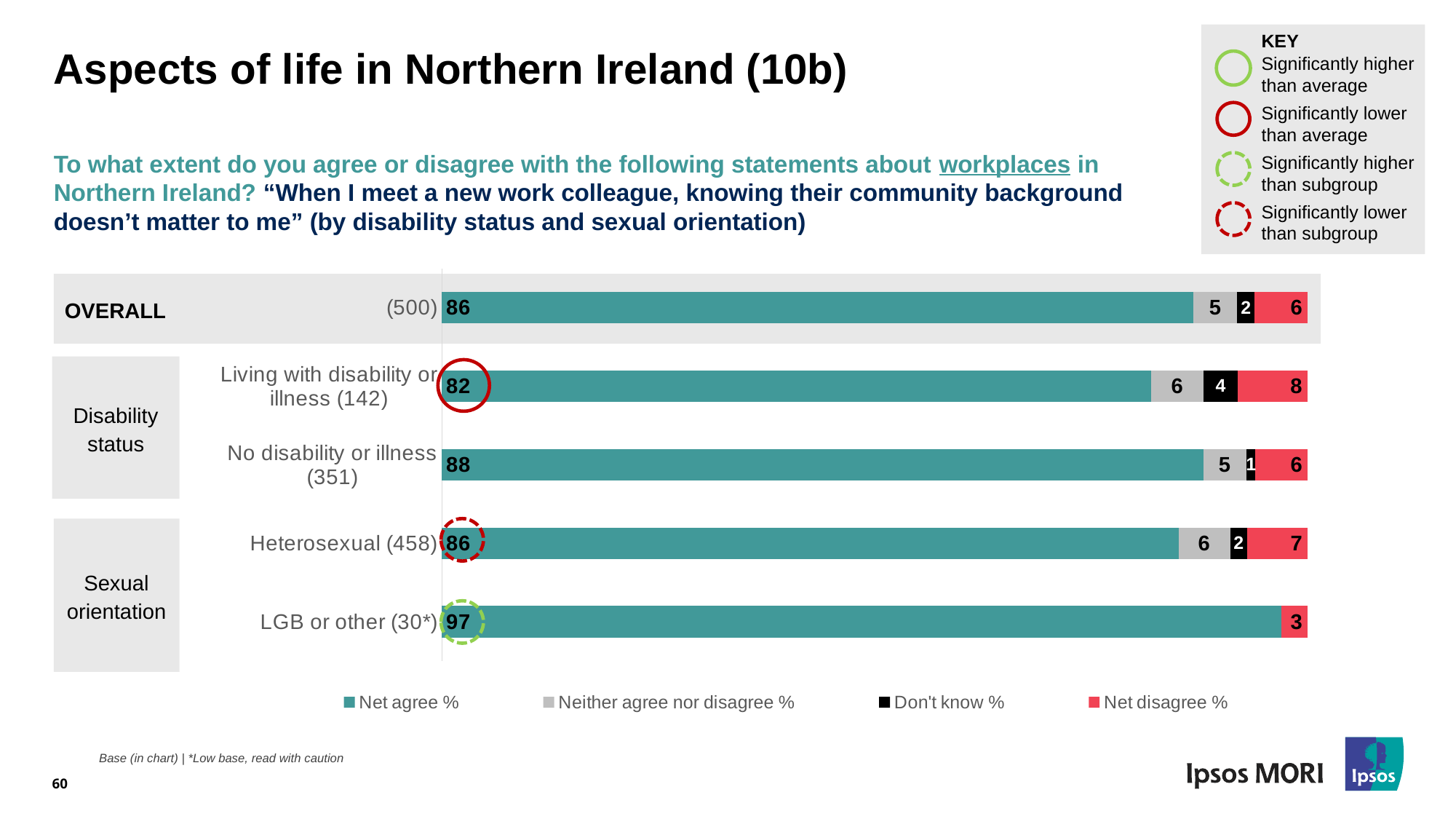
What is the Don't know % for the No disability or illness group? 1 What is the base size shown for the Heterosexual group? 458 What is the Neither agree nor disagree % for the Heterosexual group? 6 What is the Net agree % for the LGB or other group? 97 What is the difference in Net agree % between the No disability or illness group and the Living with disability or illness group? 6 Which group has the highest Net agree %? LGB or other How many groups (bars) are shown in the chart? 5 What is the Net disagree % for the Living with disability or illness group? 8 What type of chart is shown on the slide? Stacked bar chart Which has a higher Net disagree %, the Heterosexual group or the Overall group? Heterosexual Which group has the lowest Net agree %? Living with disability or illness How many series does the chart legend list? 4